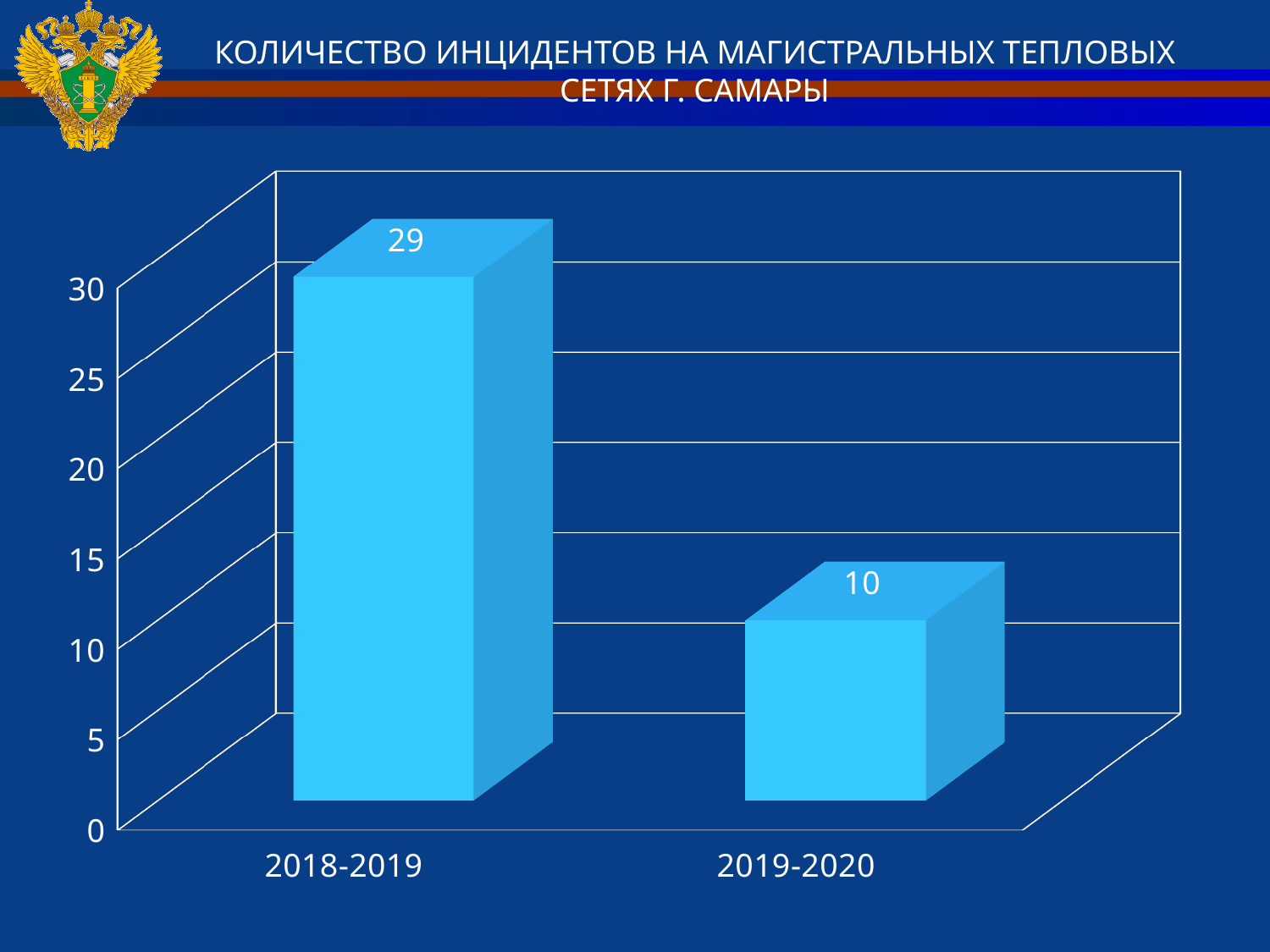
Is the value for 2018-2019 greater or less than 25? greater What is the difference between the values for 2018-2019 and 2019-2020? 19 What is the value for 2019-2020? 10 What is the title of the chart? КОЛИЧЕСТВО ИНЦИДЕНТОВ НА МАГИСТРАЛЬНЫХ ТЕПЛОВЫХ СЕТЯХ Г. САМАРЫ What kind of chart is shown on the slide? bar chart What is the value for 2018-2019? 29 Is the value for 2019-2020 greater or less than 15? less Do the values rise or fall from 2018-2019 to 2019-2020? fall Which period has the highest number of incidents? 2018-2019 How many categories are shown on the x axis? 2 Which is larger, the value for 2018-2019 or the value for 2019-2020? 2018-2019 Which period has the lowest number of incidents? 2019-2020